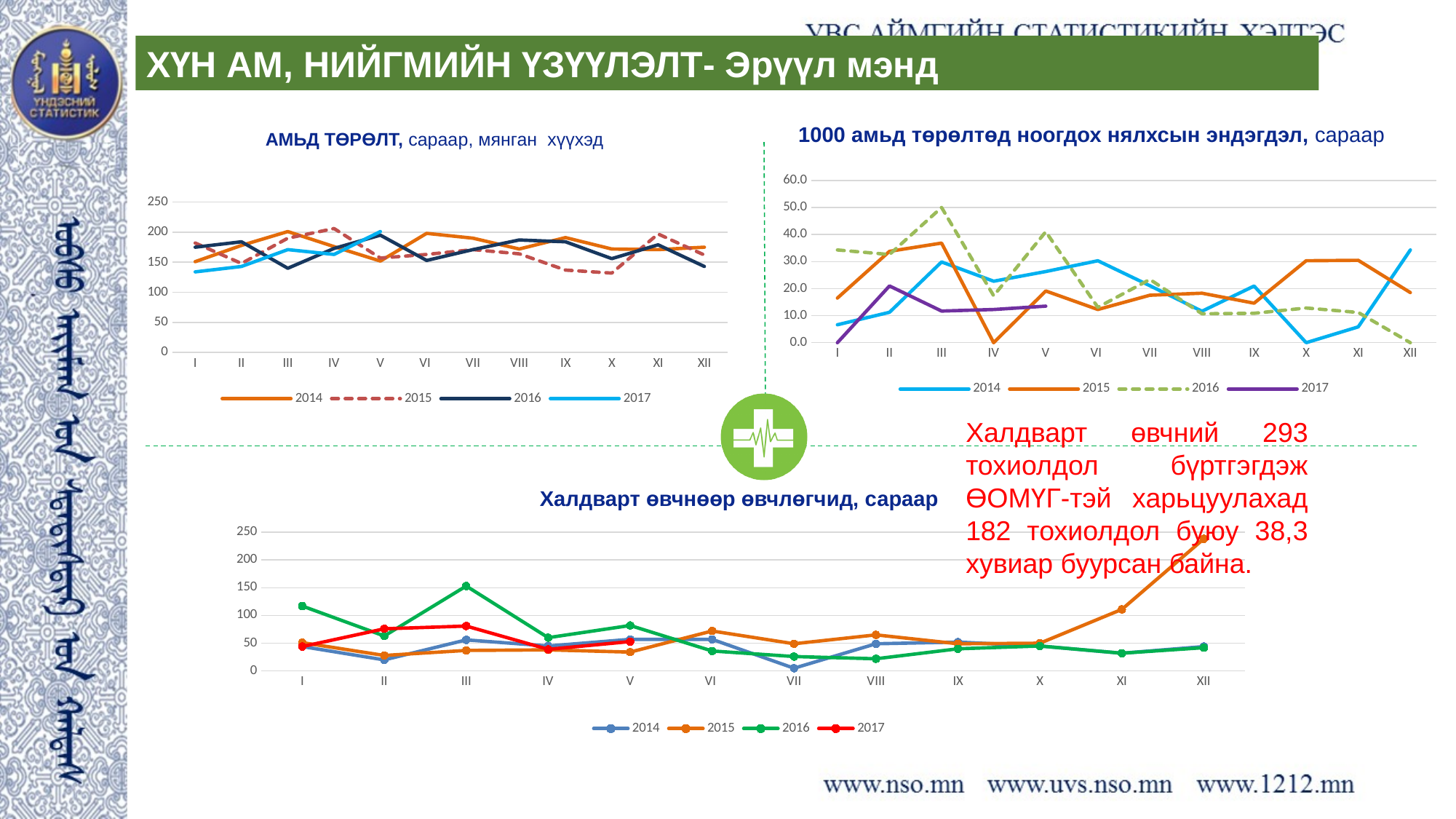
What kind of chart is the chart titled "Халдварт өвчнөөр өвчлөгчид, сараар" at the bottom of the slide? Line chart How many months (categories) are shown on the x axis of the bottom chart "Халдварт өвчнөөр өвчлөгчид, сараар"? 12 How many series does the legend of the top-left chart "АМЬД ТӨРӨЛТ, сараар, мянган хүүхэд" list? 4 In the bottom chart "Халдварт өвчнөөр өвчлөгчид, сараар", is the value for 2014 in month VII greater or less than 50? less In the top-right chart "1000 амьд төрөлтөд ноогдох нялхсын эндэгдэл, сараар", which series is drawn with a dashed line? 2016 In the top-right chart "1000 амьд төрөлтөд ноогдох нялхсын эндэгдэл, сараар", does the 2016 series rise or fall from month X to month XII? fall In the bottom chart "Халдварт өвчнөөр өвчлөгчид, сараар", is the value for 2015 in month XII greater or less than 200? greater In the bottom chart "Халдварт өвчнөөр өвчлөгчид, сараар", is the value for 2016 in month III greater or less than 100? greater In the bottom chart "Халдварт өвчнөөр өвчлөгчид, сараар", does the 2015 series rise or fall from month X to month XII? rise